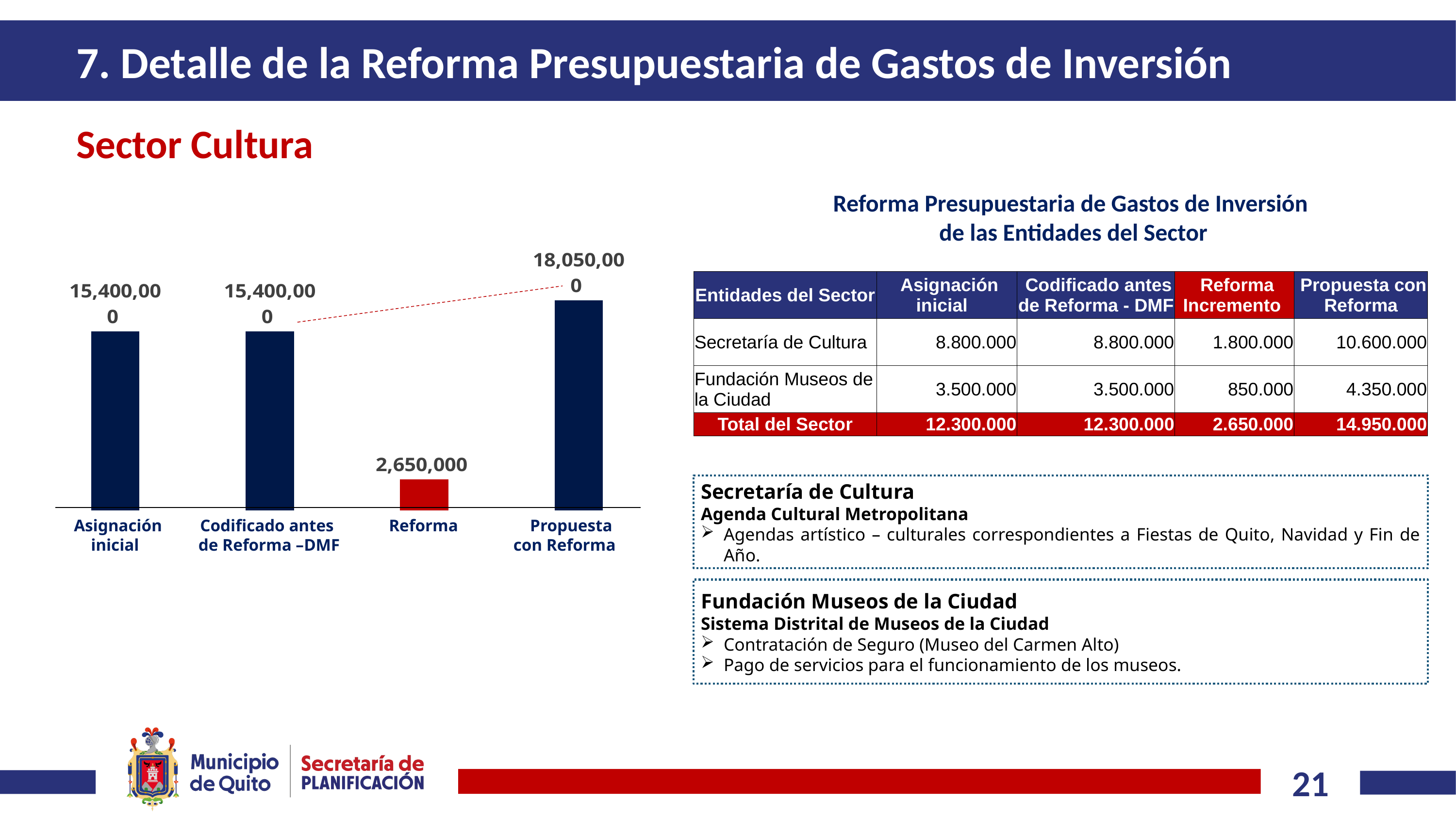
What is the value of the Reforma bar in the chart? 2,650,000 Which is larger in the chart, the Reforma bar or the Asignación inicial bar? Asignación inicial What is the difference between the Propuesta con Reforma bar and the Reforma bar? 15,400,000 What colour is the Reforma bar in the chart? Red What is the value of the Asignación inicial bar in the chart? 15,400,000 What is the value of the Propuesta con Reforma bar in the chart? 18,050,000 What kind of chart is shown on the left of the slide? Bar chart What is the value of the Codificado antes de Reforma –DMF bar in the chart? 15,400,000 Which category has the highest bar in the chart? Propuesta con Reforma Which category has the lowest bar in the chart? Reforma What is the difference between the Propuesta con Reforma bar and the Codificado antes de Reforma –DMF bar? 2,650,000 How many bars are plotted in the chart? 4